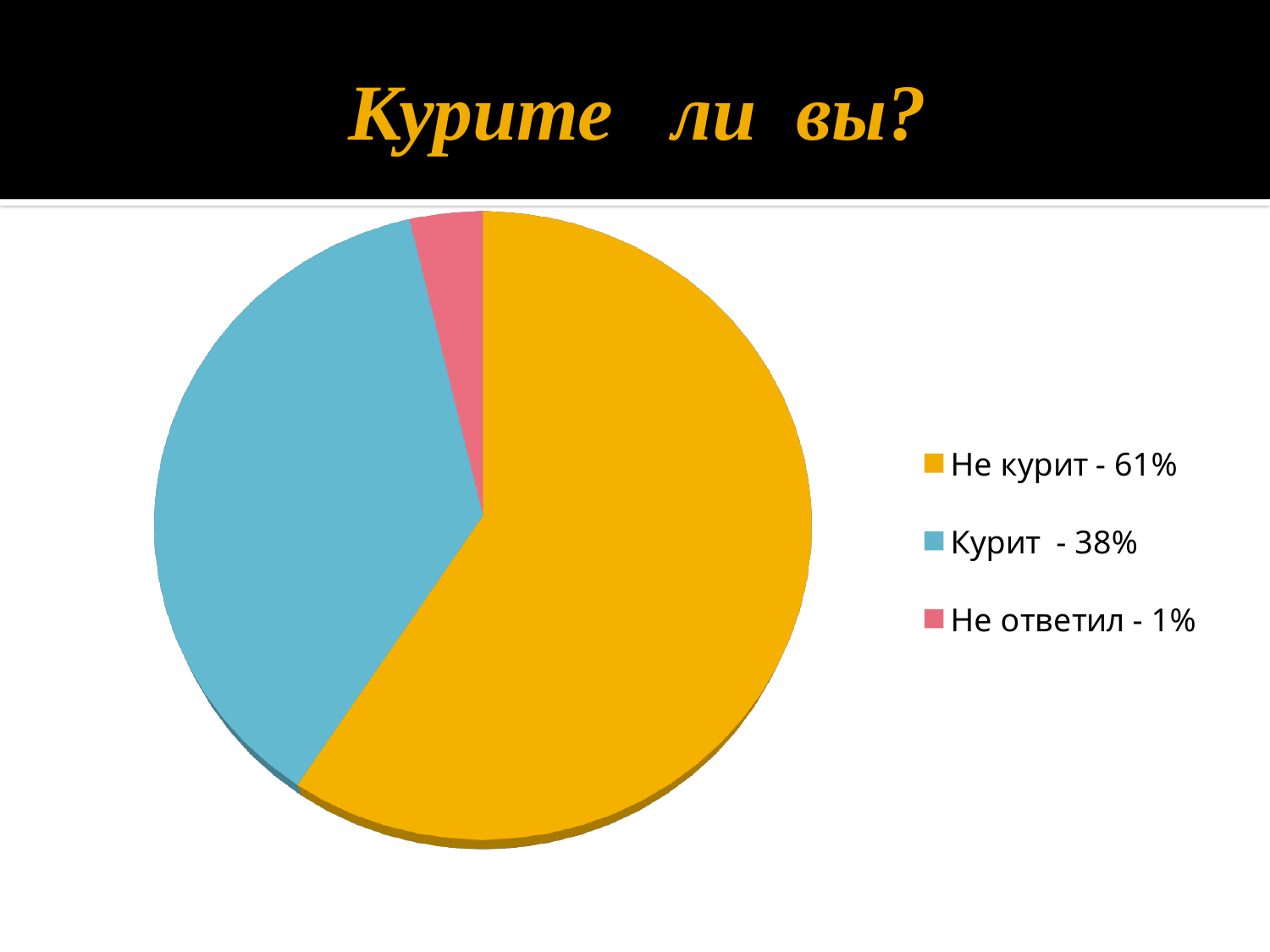
Which is larger, the share for "Курит" or the share for "Не ответил"? Курит What share of the pie does "Не курит" have? 61% What share of the pie does "Не ответил" have? 1% Which category has the smallest slice of the pie? Не ответил What share of the pie does "Курит" have? 38% What is the title of the slide with the chart? Курите ли вы? How many entries does the legend list? 3 What colour is the slice for "Курит"? blue What is the difference between the shares of "Не курит" and "Курит"? 23% What kind of chart is shown on the slide? pie chart Which category has the largest slice of the pie? Не курит How many categories does the pie chart have? 3